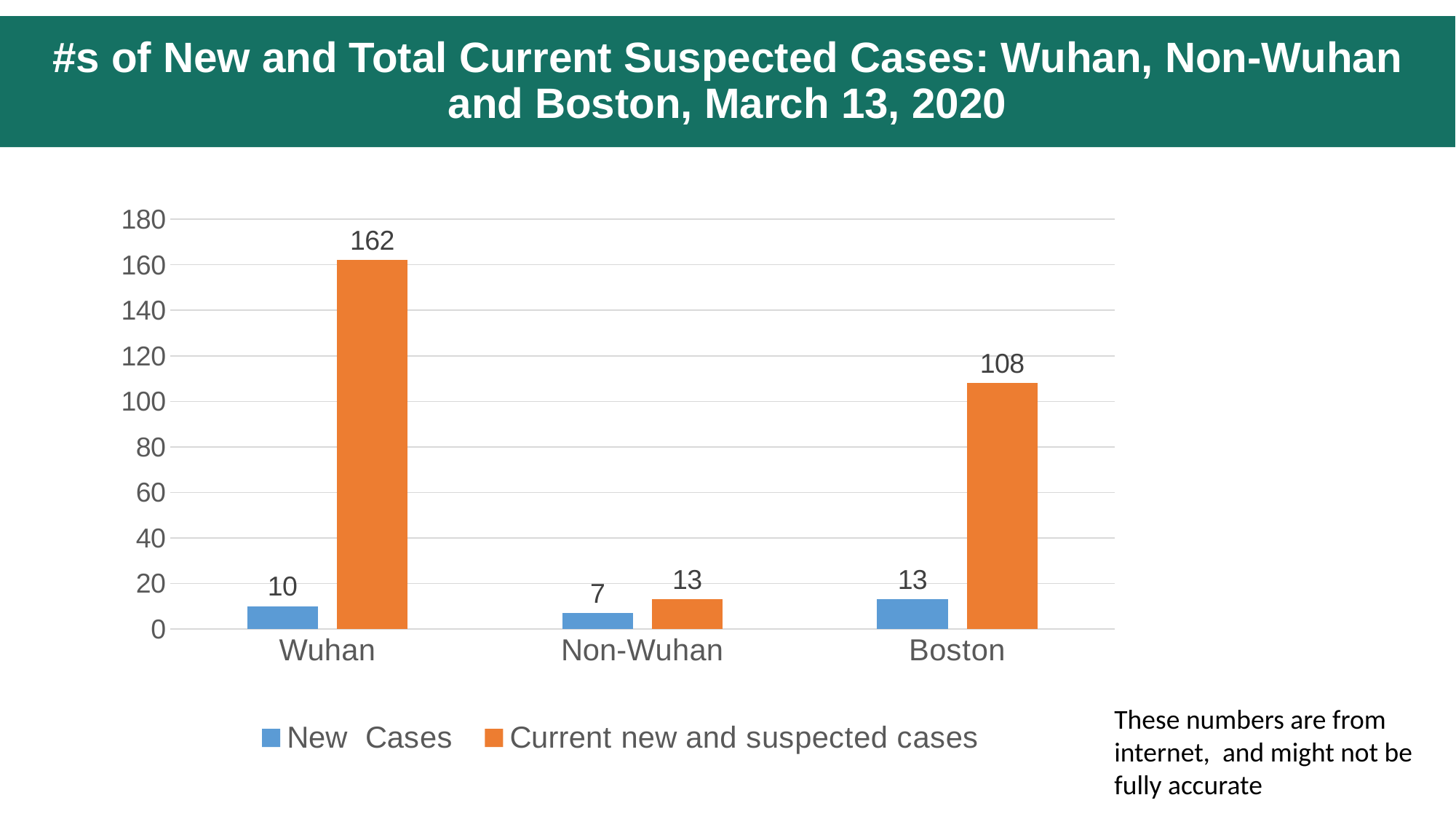
Which category has the highest value for Current new and suspected cases? Wuhan Which category has the lowest value for New Cases? Non-Wuhan What is the value of New Cases for Non-Wuhan? 7 How many categories are shown on the x axis? 3 Which is larger: New Cases for Boston or New Cases for Wuhan? Boston What kind of chart is shown on the slide? Bar chart Is the value of Current new and suspected cases for Boston greater or less than 100? greater How many series does the legend list? 2 What is the difference between Current new and suspected cases for Wuhan and Boston? 54 Which colour represents the New Cases series? Blue What is the value of New Cases for Wuhan? 10 What is the value of Current new and suspected cases for Boston? 108